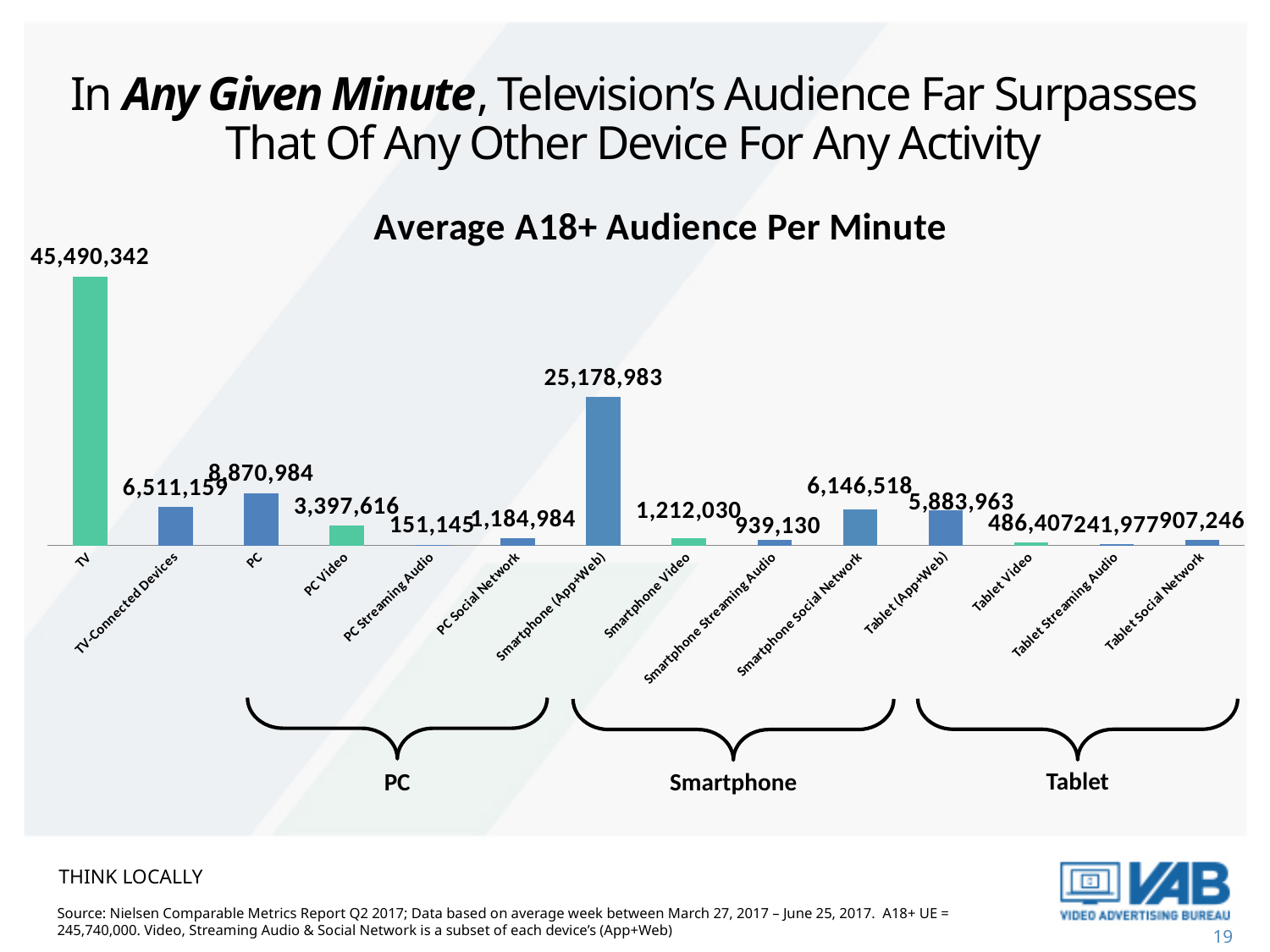
What is the value shown for Tablet Video? 486,407 What kind of chart is shown on the slide? Bar chart What is the difference between the values for Smartphone Social Network and Tablet (App+Web)? 262,555 How many categories are plotted in the chart? 14 What is the title of the chart? Average A18+ Audience Per Minute What is the Average A18+ Audience Per Minute for TV? 45,490,342 What is the value shown for PC Social Network? 1,184,984 What is the value shown for Smartphone (App+Web)? 25,178,983 Which category has the highest Average A18+ Audience Per Minute? TV Which is larger, the value for PC or the value for TV-Connected Devices? PC Which category has the lowest Average A18+ Audience Per Minute? PC Streaming Audio What is the difference between the values for TV and Smartphone (App+Web)? 20,311,359